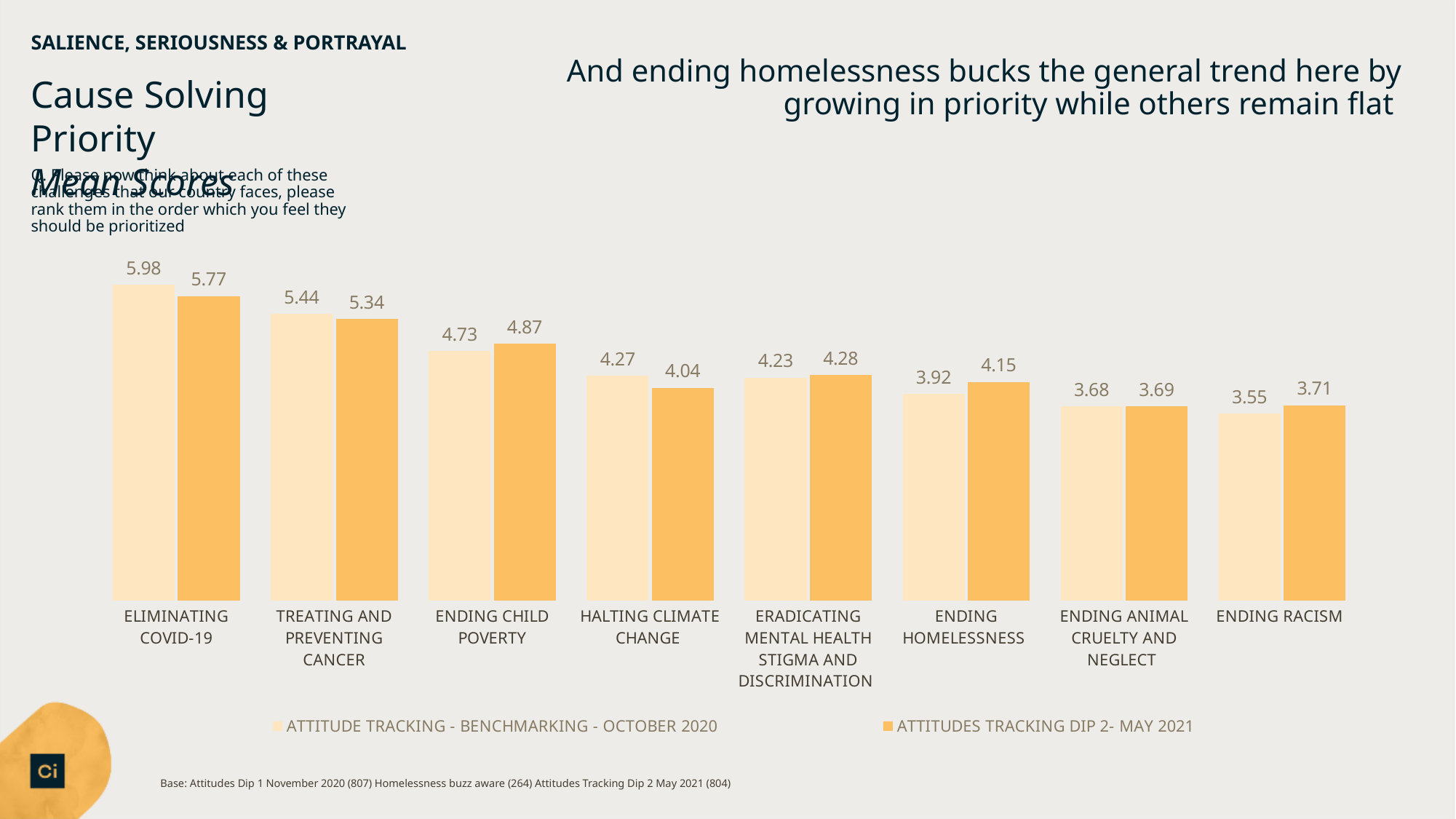
What is the difference between the May 2021 and October 2020 mean scores for Ending Homelessness? 0.23 For Halting Climate Change, which is larger: the October 2020 score or the May 2021 score? October 2020 What is the October 2020 mean score for Ending Racism? 3.55 What is the difference between the October 2020 and May 2021 mean scores for Eliminating COVID-19? 0.21 Which cause has the highest mean score in the May 2021 series? Eliminating COVID-19 What is the May 2021 mean score for Halting Climate Change? 4.04 How many series does the chart legend list? 2 What type of chart is shown on the slide? Bar chart Which cause has the lowest mean score in the October 2020 series? Ending Racism What is the October 2020 mean score for Ending Homelessness? 3.92 What is the May 2021 mean score for Ending Homelessness? 4.15 How many causes are shown on the x axis of the chart? 8